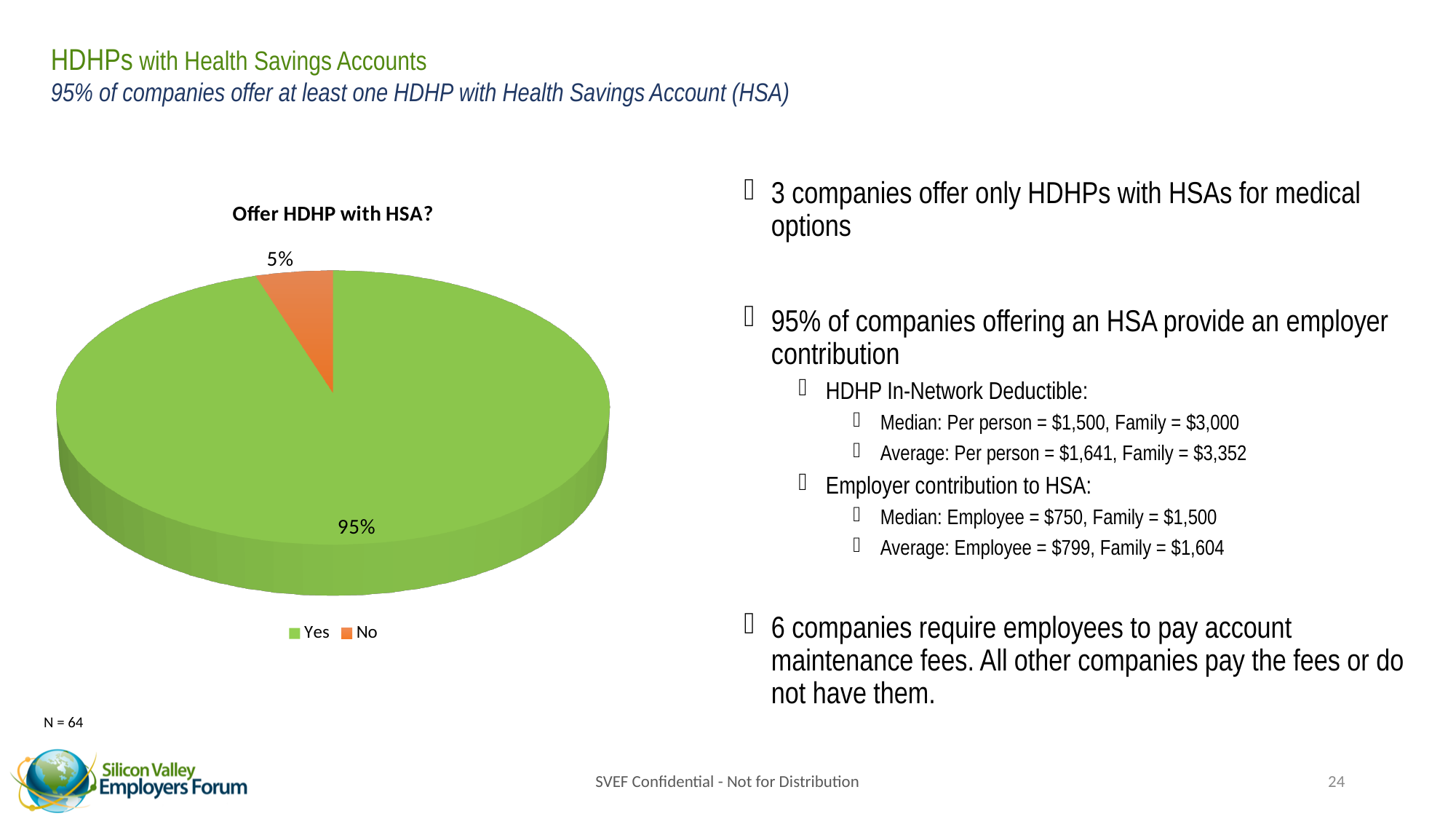
What share of the pie does the No slice represent? 5% What colour is the Yes slice of the pie? Green Which category has the largest share of the pie? Yes Which slice is larger, Yes or No? Yes How many categories does the pie chart show? 2 How many entries does the legend list? 2 What is the difference in percentage points between the Yes and No slices? 90 percentage points What is the title of the chart? Offer HDHP with HSA? What type of chart is shown on the slide? Pie chart What percentage of companies answered No to offering an HDHP with HSA? 5% What percentage of companies answered Yes to offering an HDHP with HSA? 95% Which category has the smallest share of the pie? No